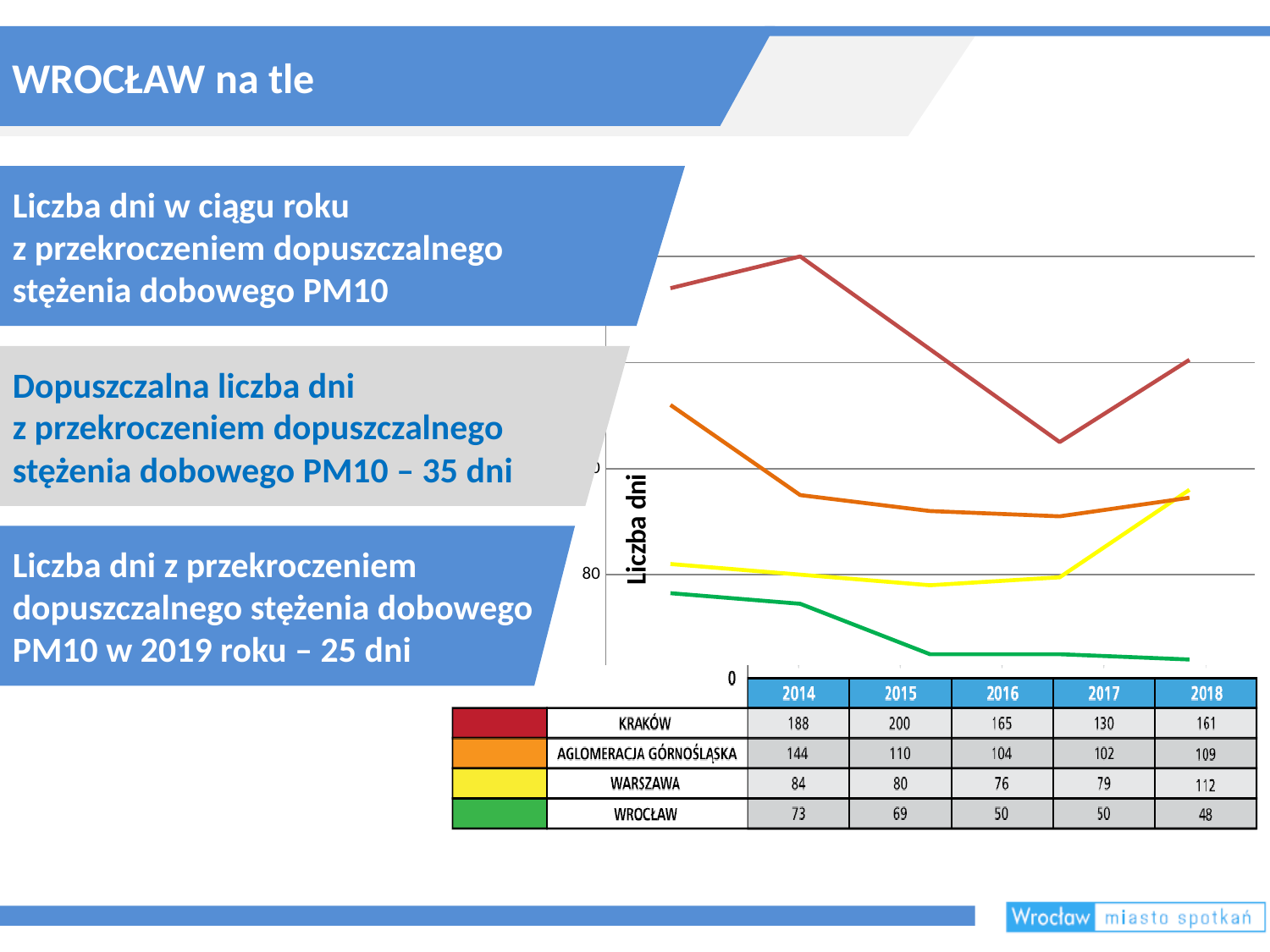
What is the value for WARSZAWA in 2016? 76 Which is larger in 2018, the value for WARSZAWA or the value for AGLOMERACJA GÓRNOŚLĄSKA? WARSZAWA Which series has the lowest value in 2018? WROCŁAW Which series has the highest value in 2014? KRAKÓW What is the value for AGLOMERACJA GÓRNOŚLĄSKA in 2017? 102 What is the value for KRAKÓW in 2015? 200 Does the WROCŁAW series rise or fall from 2014 to 2018? fall How many years are plotted along the x axis? 5 What is the difference between the KRAKÓW value in 2015 and its value in 2017? 70 How many series does the chart's data table list? 4 What is the value for WROCŁAW in 2018? 48 What kind of chart is shown on the slide? line chart